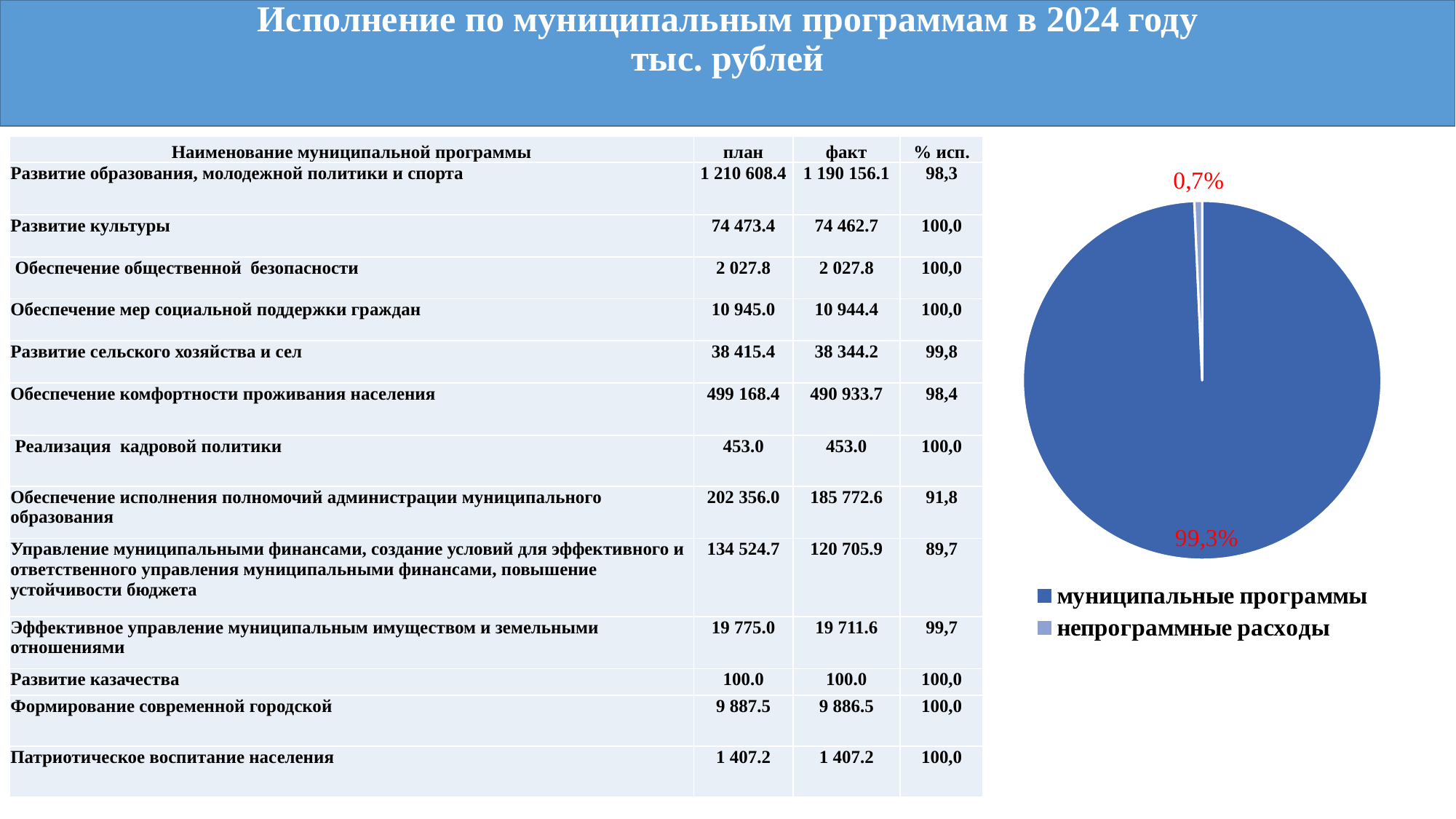
How many entries does the pie chart's legend list? 2 Which slice of the pie chart is the smallest? непрограммные расходы By how many percentage points does the "муниципальные программы" slice exceed the "непрограммные расходы" slice in the pie chart? 98,6 Which slice of the pie chart is the largest? муниципальные программы What share of the pie chart does "непрограммные расходы" take? 0,7% What share of the pie chart does "муниципальные программы" take? 99,3% In the pie chart, which is larger: "муниципальные программы" or "непрограммные расходы"? муниципальные программы What colour is the "муниципальные программы" slice in the pie chart? dark blue Is the share of "муниципальные программы" in the pie chart greater or less than 50%? greater What kind of chart is shown on the right side of the slide? pie chart How many slices does the pie chart have? 2 What is the second entry listed in the pie chart's legend? непрограммные расходы